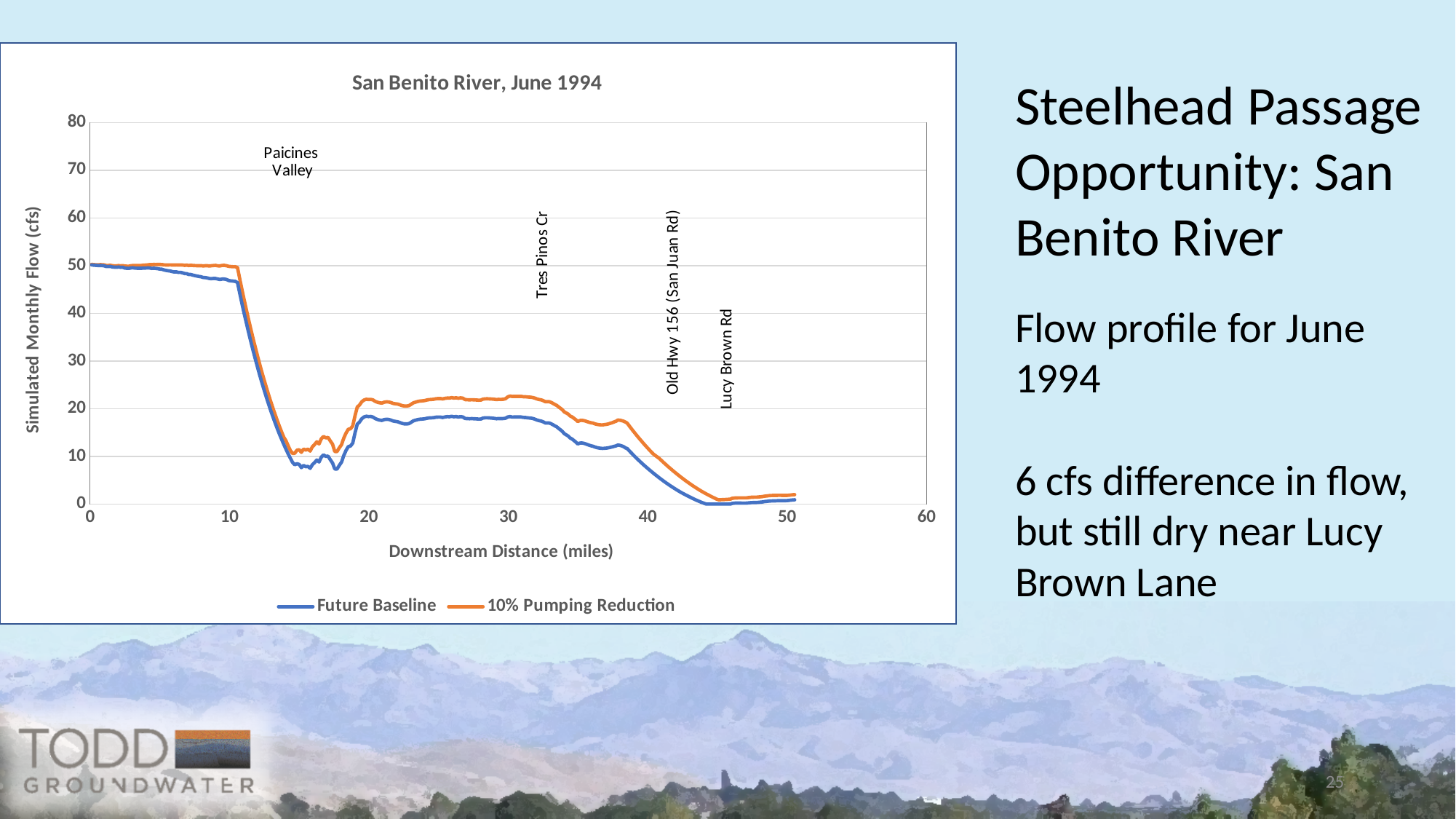
What is the title of the chart? San Benito River, June 1994 How many series does the chart legend list? 2 At 5 miles downstream, is the Future Baseline flow greater or less than 40 cfs? greater What kind of chart is shown on the slide? Line chart Overall, does the simulated monthly flow rise or fall as downstream distance increases from 0 to 50 miles? Fall At 30 miles downstream, which series shows the higher flow, Future Baseline or 10% Pumping Reduction? 10% Pumping Reduction What is the highest value shown on the y axis of the chart? 80 At 15 miles downstream, is the 10% Pumping Reduction flow greater or less than 30 cfs? less At 30 miles downstream, is the Future Baseline flow greater or less than 20 cfs? less What is the label of the chart's x axis? Downstream Distance (miles)